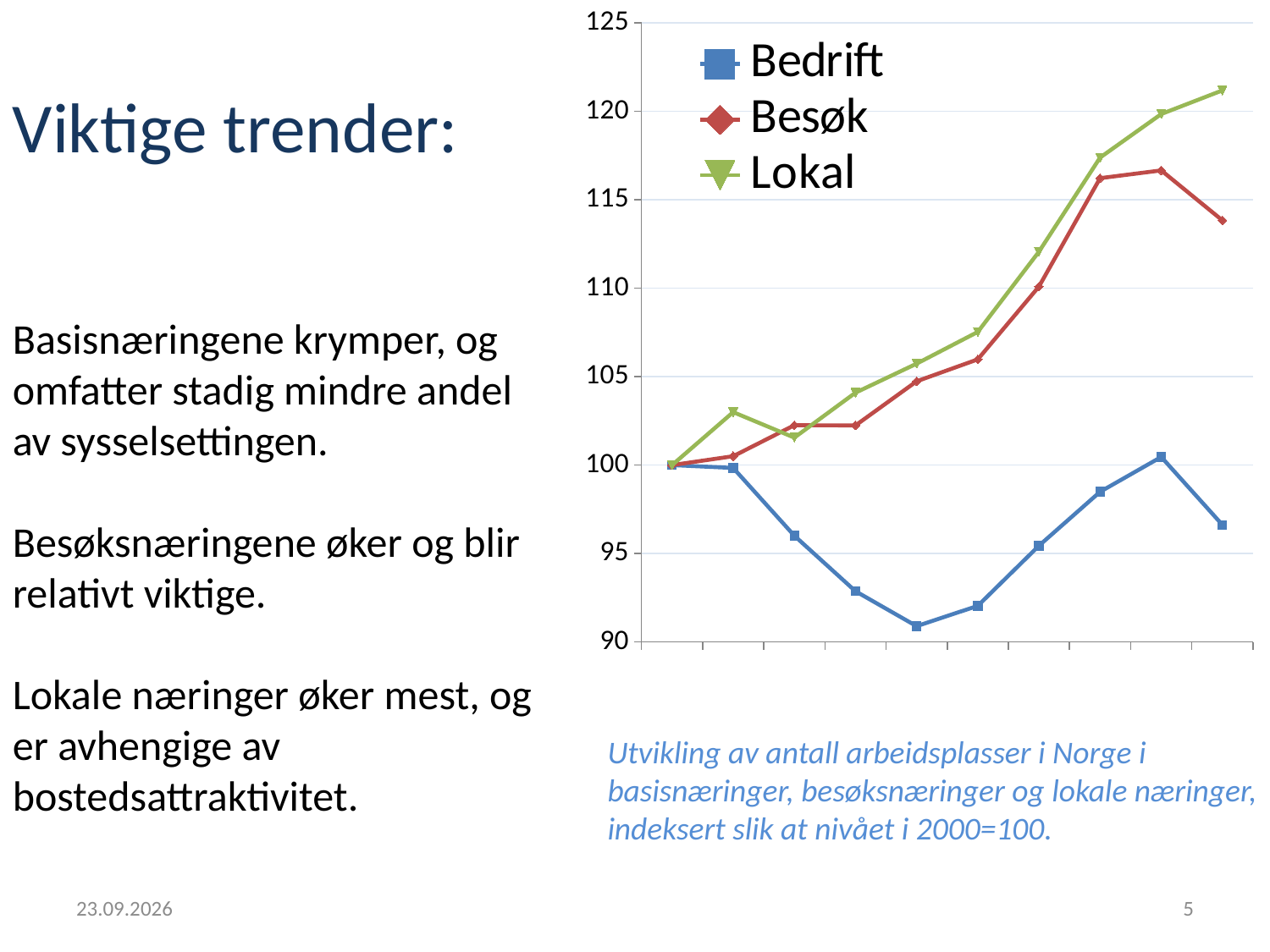
Which series has the highest value at the last point of the chart? Lokal What is the value of all three series at the first point of the chart? 100 Is the last value of the Besøk series greater or less than 115? less Does the Lokal series generally rise or fall along the x axis? rise Which colour is used for the Bedrift series in the chart? blue What kind of chart is shown on the slide? line chart Which series has the lowest value at the last point of the chart? Bedrift At the last point of the chart, which is larger: Besøk or Bedrift? Besøk How many series does the chart's legend list? 3 Is the last value of the Lokal series greater or less than 120? greater How many data points does each line in the chart have? 10 Is the lowest value of the Bedrift series greater or less than 95? less